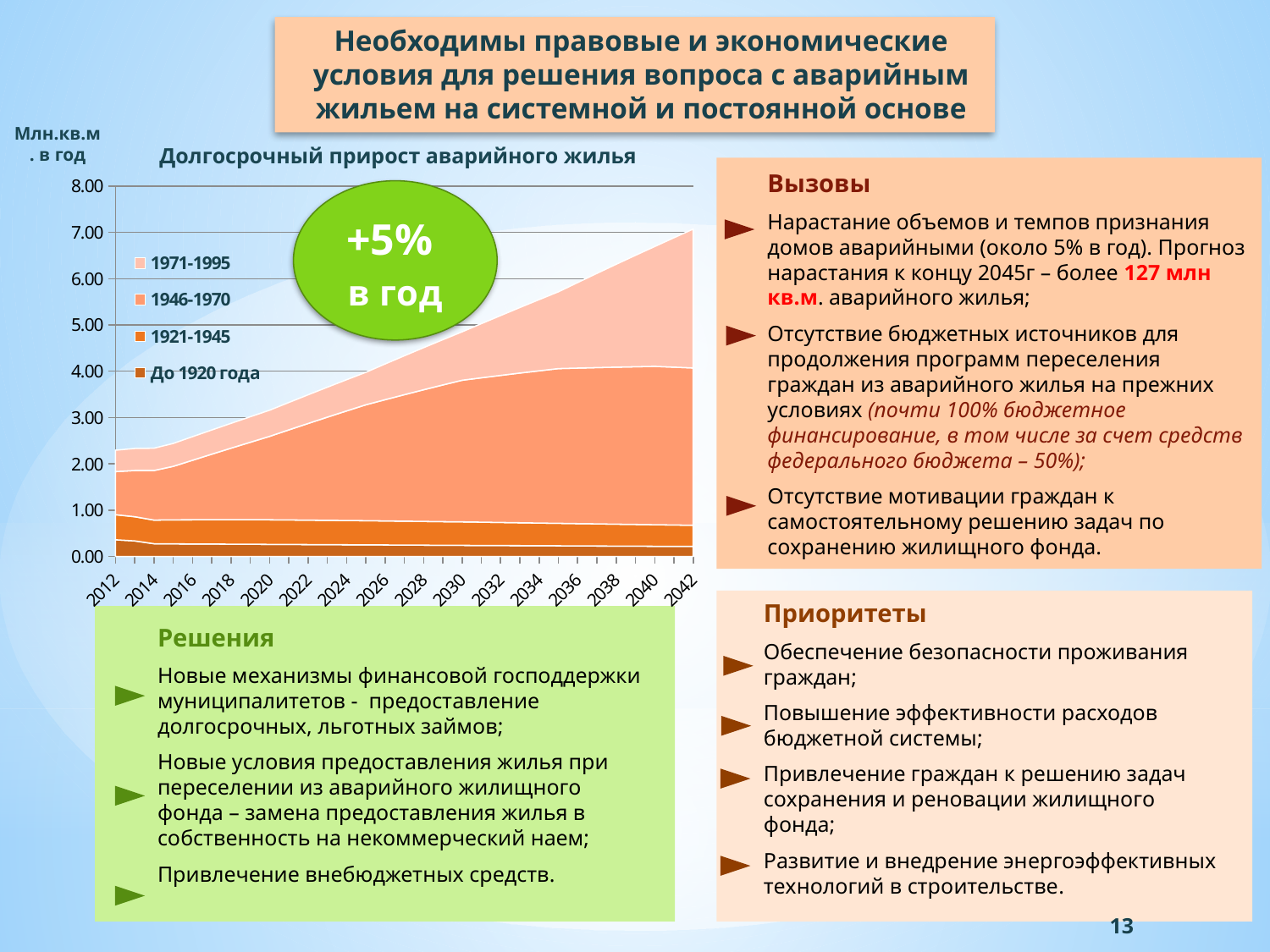
What kind of chart is shown on the slide? Area chart Which series forms the smallest band in the chart? До 1920 года Is the total stacked value for 2040 greater or less than 6.00? greater Is the total stacked value for 2012 greater or less than 2.00? greater What is the highest value shown on the y axis of the chart? 8.00 How many year labels are shown along the x axis of the chart? 16 Does the total stacked value in the chart rise or fall from 2012 to 2042? Rise How many series does the chart legend list? 4 What is the first year shown on the x axis of the chart? 2012 What is the title of the chart? Долгосрочный прирост аварийного жилья Which series is listed first in the chart legend? 1971-1995 What is the last year shown on the x axis of the chart? 2042